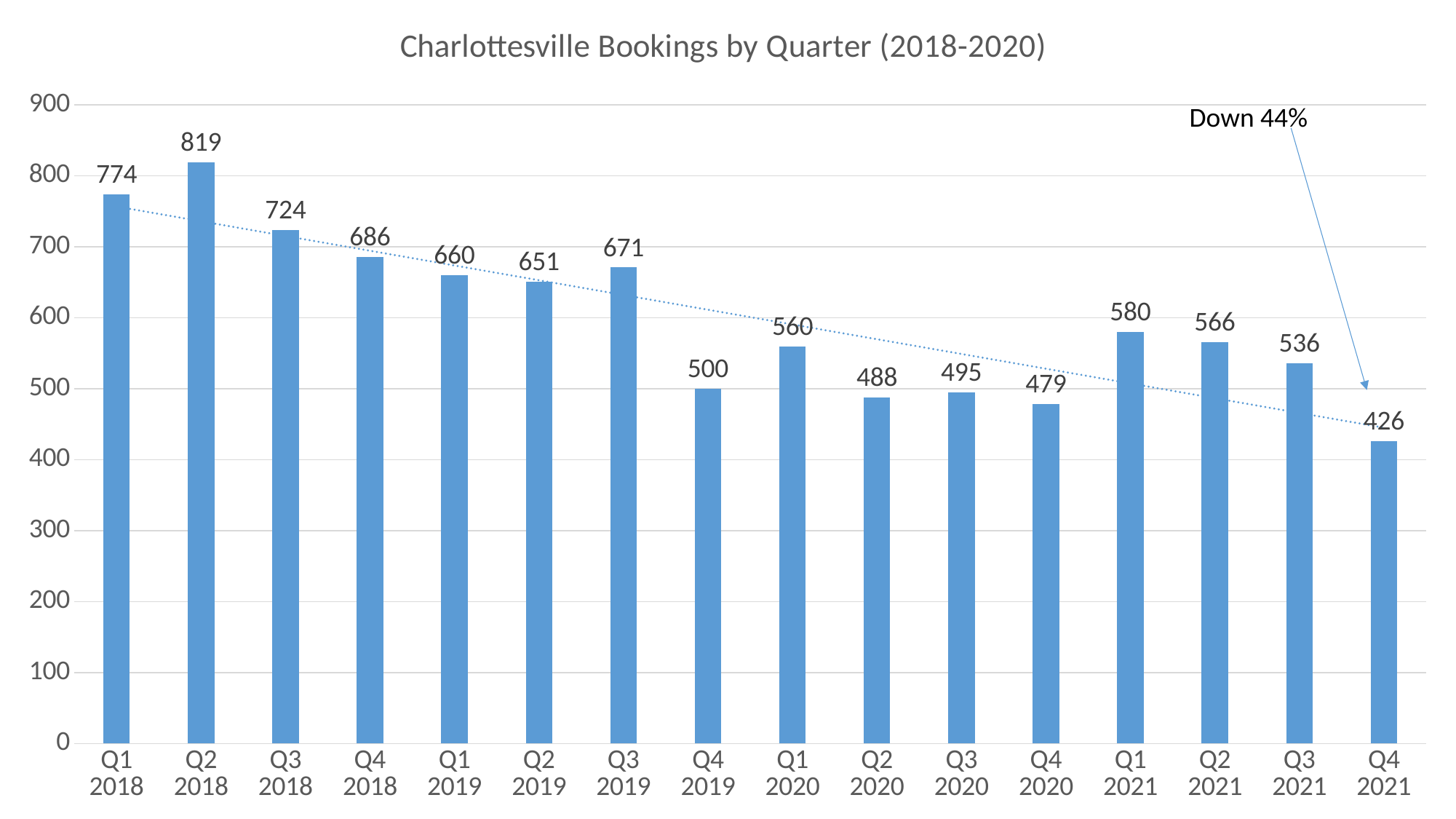
Which is larger, the value for Q3 2019 or the value for Q2 2019? Q3 2019 What is the title of the chart? Charlottesville Bookings by Quarter (2018-2020) Is the value for Q4 2020 greater or less than 500? less How many quarters are shown on the x axis? 16 What is the value for Q2 2018? 819 What is the value for Q1 2020? 560 Which quarter has the lowest number of bookings? Q4 2021 What kind of chart is shown on the slide? bar chart What is the difference between the values for Q1 2018 and Q4 2021? 348 Which quarter has the highest number of bookings? Q2 2018 Do the values generally rise or fall from Q1 2018 to Q4 2021? fall What is the value for Q4 2021? 426